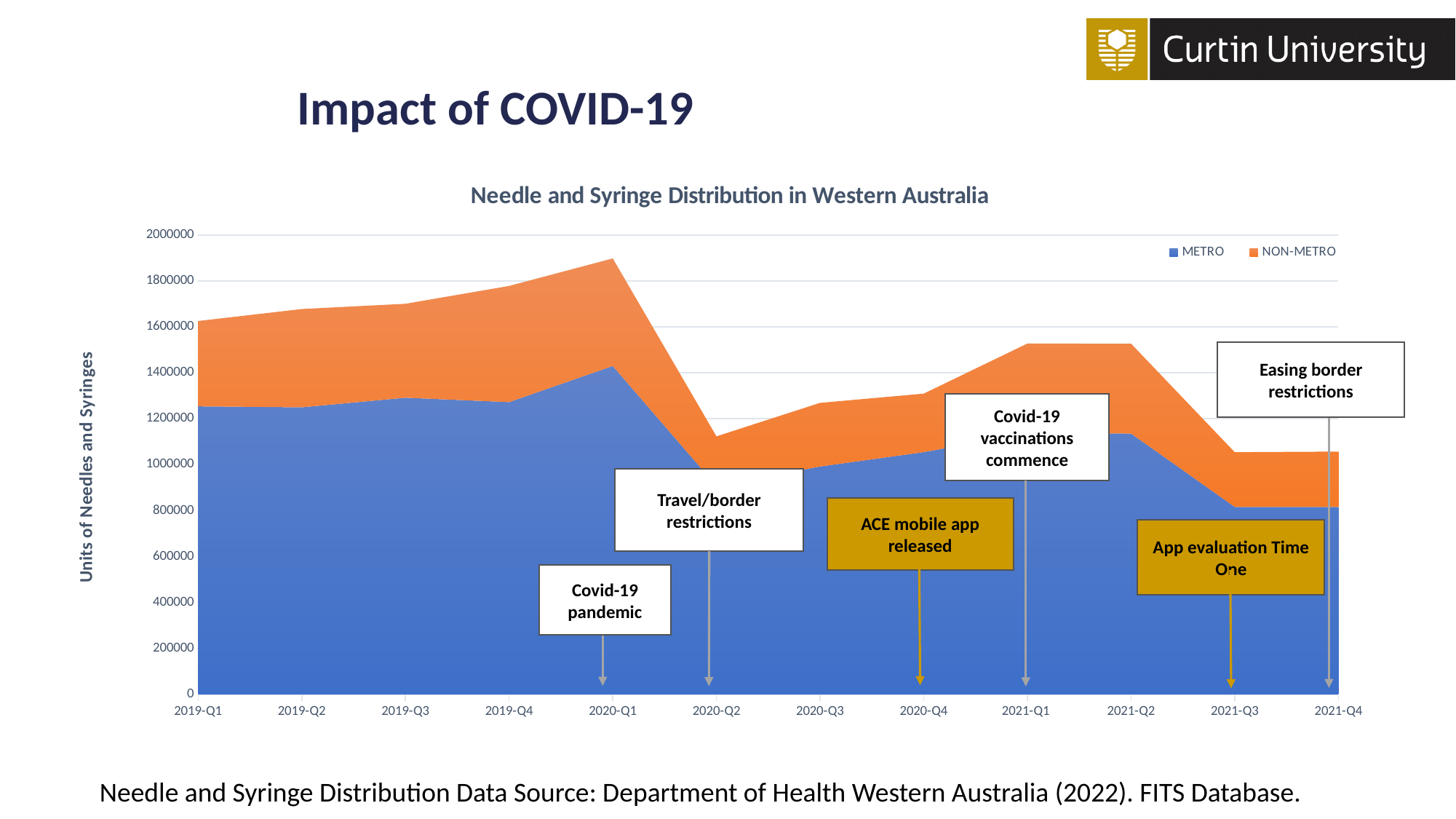
Is the combined total for 2020-Q2 greater or less than 1200000? less Is the METRO value for 2019-Q1 greater or less than 1000000? greater Does the combined total rise or fall between 2020-Q2 and 2021-Q1? rise How many quarters are shown along the x axis? 12 Does the combined total rise or fall between 2020-Q1 and 2020-Q2? fall In which quarter is the METRO series at its highest? 2020-Q1 In which quarter does the combined (METRO plus NON-METRO) distribution reach its highest point? 2020-Q1 What is the title of the chart? Needle and Syringe Distribution in Western Australia Is the combined total for 2020-Q1 greater or less than 1800000? greater What kind of chart is shown on the slide? Stacked area chart How many series does the legend list? 2